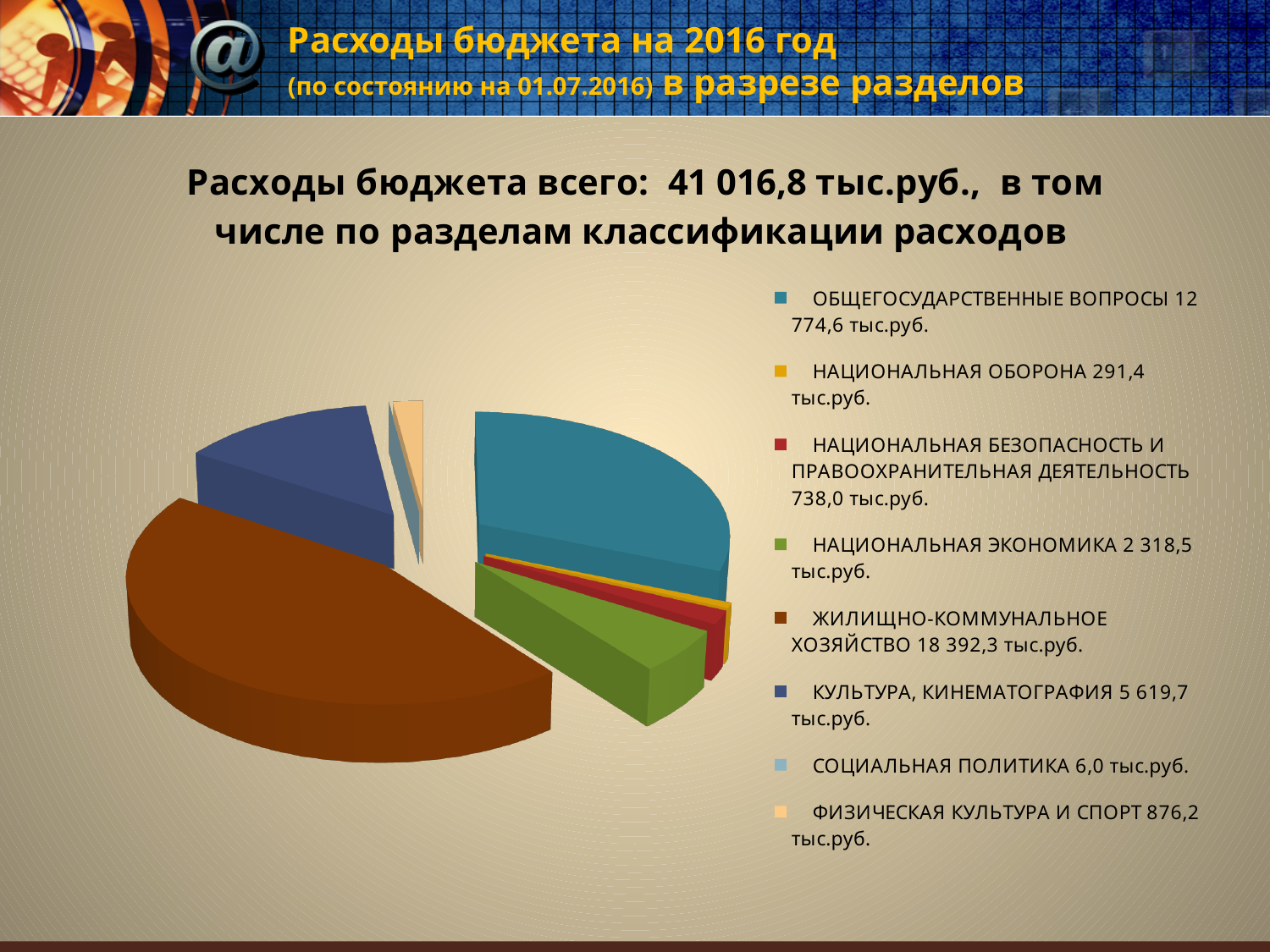
What is the difference between ЖИЛИЩНО-КОММУНАЛЬНОЕ ХОЗЯЙСТВО and ОБЩЕГОСУДАРСТВЕННЫЕ ВОПРОСЫ? 5 617,7 тыс.руб. What is the value for НАЦИОНАЛЬНАЯ ОБОРОНА? 291,4 тыс.руб. What is the value for ОБЩЕГОСУДАРСТВЕННЫЕ ВОПРОСЫ? 12 774,6 тыс.руб. Which section has the largest expenditure? ЖИЛИЩНО-КОММУНАЛЬНОЕ ХОЗЯЙСТВО Which is larger: КУЛЬТУРА, КИНЕМАТОГРАФИЯ or НАЦИОНАЛЬНАЯ ЭКОНОМИКА? КУЛЬТУРА, КИНЕМАТОГРАФИЯ Which section has the smallest expenditure? СОЦИАЛЬНАЯ ПОЛИТИКА What is the total budget expenditure stated on the slide? 41 016,8 тыс.руб. What kind of chart is shown on the slide? Pie chart What is the value for ЖИЛИЩНО-КОММУНАЛЬНОЕ ХОЗЯЙСТВО? 18 392,3 тыс.руб. What colour is the slice for ЖИЛИЩНО-КОММУНАЛЬНОЕ ХОЗЯЙСТВО? Brown What is the value for СОЦИАЛЬНАЯ ПОЛИТИКА? 6,0 тыс.руб. How many categories (sections) does the pie chart show? 8